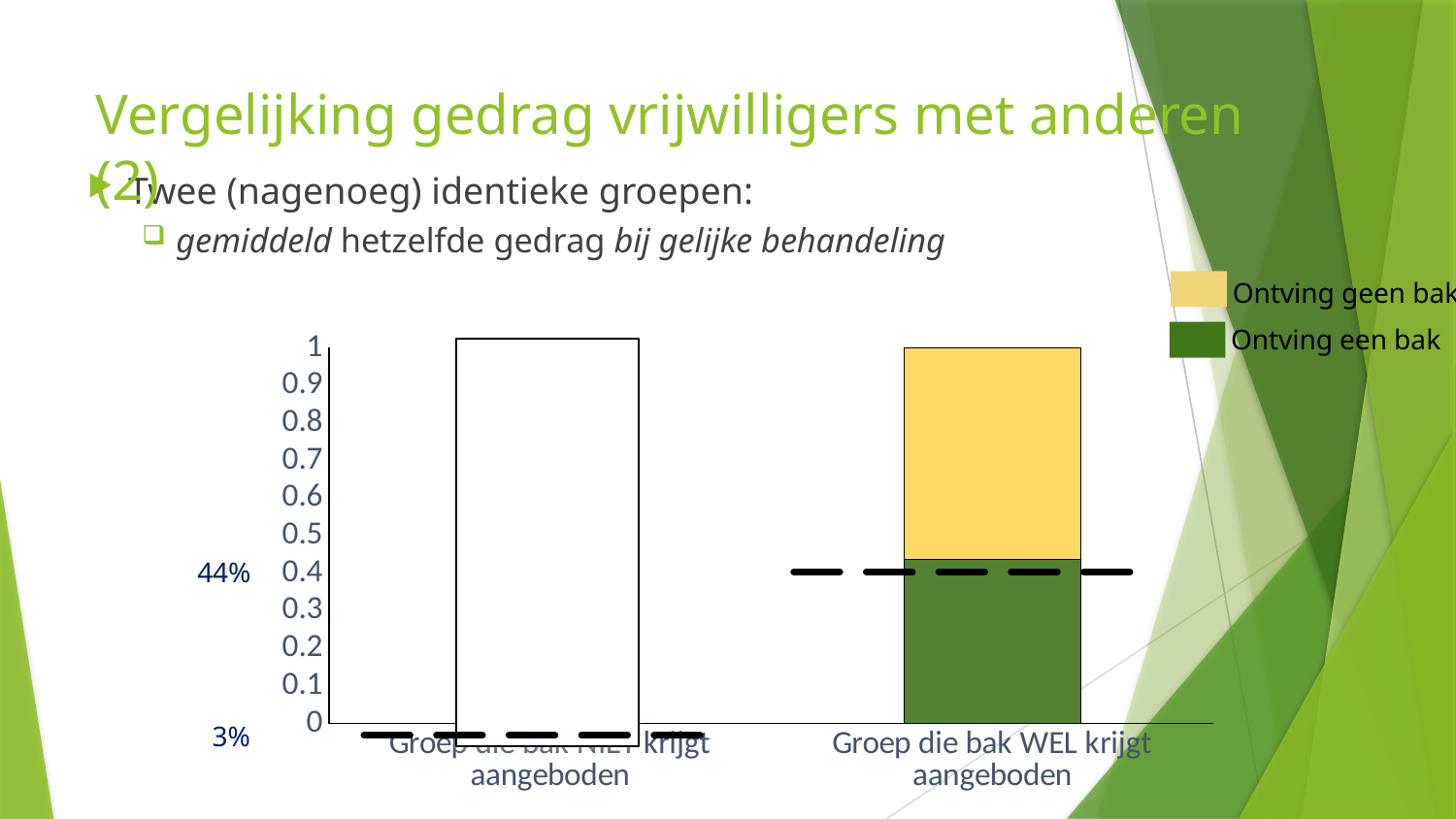
Is the 'Ontving een bak' value for 'Groep die bak WEL krijgt aangeboden' greater or less than 0.3? greater What is the highest value shown on the y axis of the chart? 1 How many series does the chart legend list? 2 Is the 'Ontving een bak' value for 'Groep die bak WEL krijgt aangeboden' greater or less than 0.5? less What is the total height of the stacked bar for 'Groep die bak WEL krijgt aangeboden'? 1 Which category has the larger 'Ontving een bak' segment? Groep die bak WEL krijgt aangeboden Which colour represents 'Ontving een bak' in the chart? green What kind of chart is shown on the slide? bar chart Which category label appears on the left of the x axis? Groep die bak NIET krijgt aangeboden What are the two entries in the chart legend? Ontving geen bak; Ontving een bak Is the 'Ontving geen bak' value for 'Groep die bak WEL krijgt aangeboden' greater or less than 0.5? greater How many categories are shown on the x axis of the chart? 2